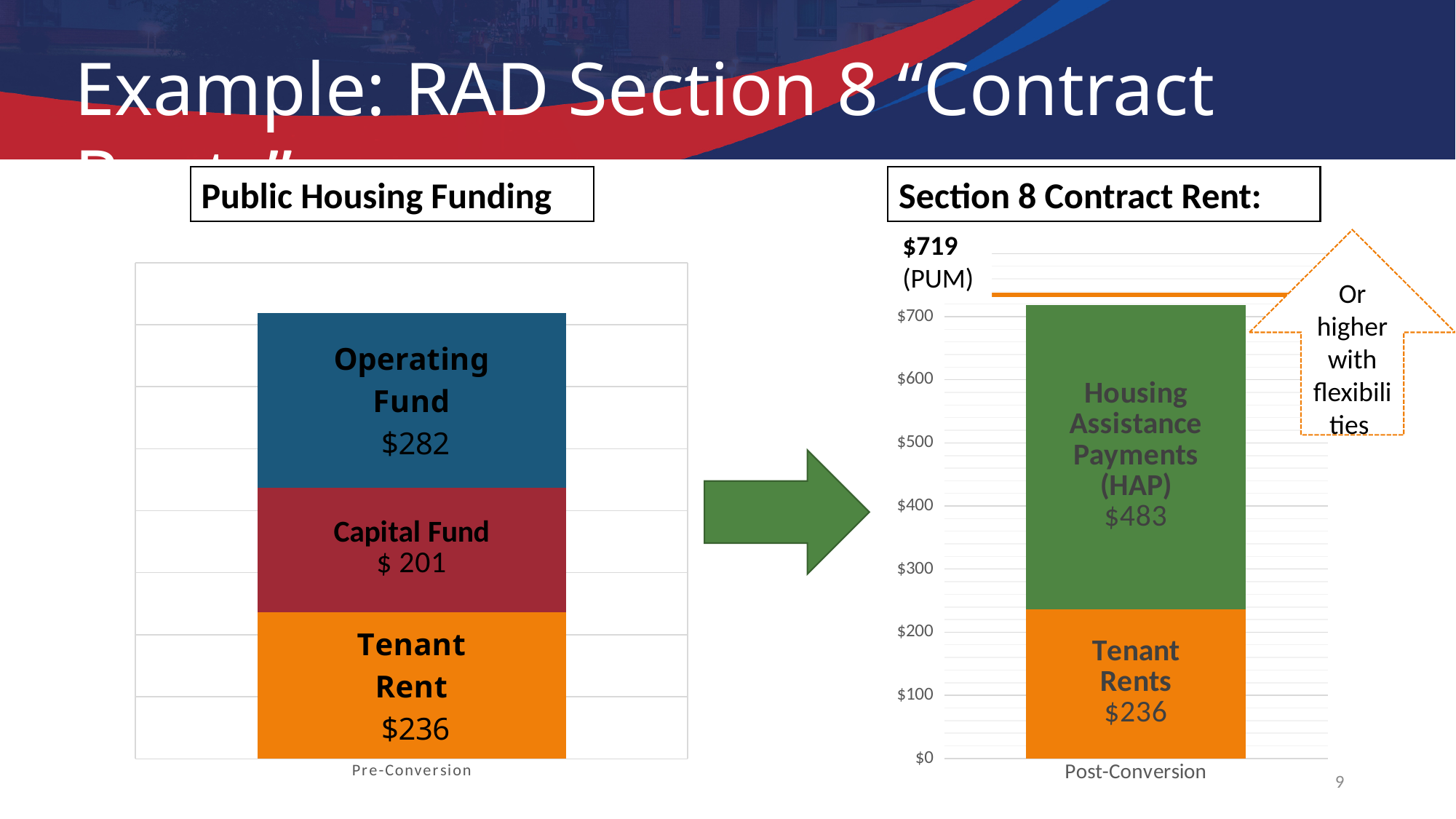
In the Public Housing Funding chart, what is the total of the Pre-Conversion stacked bar? $719 In the Public Housing Funding chart, what is the value of the Capital Fund segment? $ 201 In the Section 8 Contract Rent chart, what is the value of the Tenant Rents segment? $236 In the Section 8 Contract Rent chart, what is the value of the Housing Assistance Payments (HAP) segment? $483 In the Public Housing Funding chart, which segment is the largest? Operating Fund In the Public Housing Funding chart, what is the difference between the Operating Fund and the Capital Fund? $81 In the Public Housing Funding chart, which segment is the smallest? Capital Fund In the Public Housing Funding chart, what is the value of the Tenant Rent segment? $236 In the Public Housing Funding chart, what is the value of the Operating Fund segment? $282 In the Section 8 Contract Rent chart, what is the total of the Post-Conversion stacked bar? $719 In the Section 8 Contract Rent chart, what is the difference between Housing Assistance Payments (HAP) and Tenant Rents? $247 What kind of chart is the Section 8 Contract Rent chart? Stacked bar chart